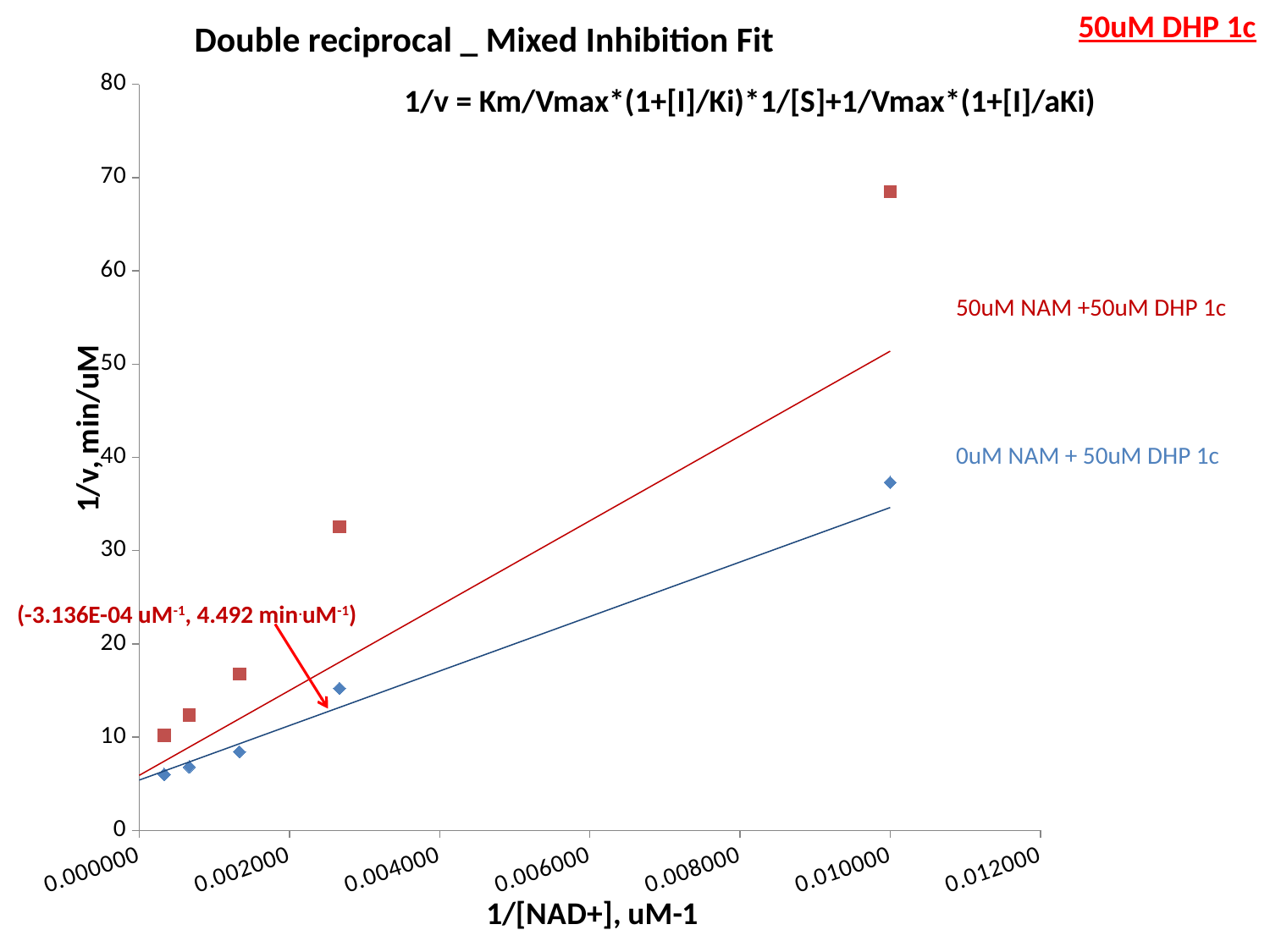
Is the 1/v value of the blue diamond point near 1/[NAD+] = 0.002700 greater or less than 20? less What coordinates are given in the red annotation pointing to where the two fitted lines intersect? (-3.136E-04 uM-1, 4.492 min·uM-1) What is the title of the chart? Double reciprocal _ Mixed Inhibition Fit Is the 1/v value of the rightmost blue diamond point (at 1/[NAD+] of about 0.010000) greater or less than 40? less Do the 1/v values rise or fall as 1/[NAD+] increases along the x axis? rise How many red square data points are plotted for the 50uM NAM +50uM DHP 1c series? 5 Is the 1/v value of the rightmost red square point (at 1/[NAD+] of about 0.010000) greater or less than 60? greater How many blue diamond data points are plotted for the 0uM NAM + 50uM DHP 1c series? 5 At the highest 1/[NAD+] value plotted, which series has the larger 1/v: 50uM NAM +50uM DHP 1c or 0uM NAM + 50uM DHP 1c? 50uM NAM +50uM DHP 1c What kind of chart is shown on the slide? scatter chart How many data series are plotted on the chart? 2